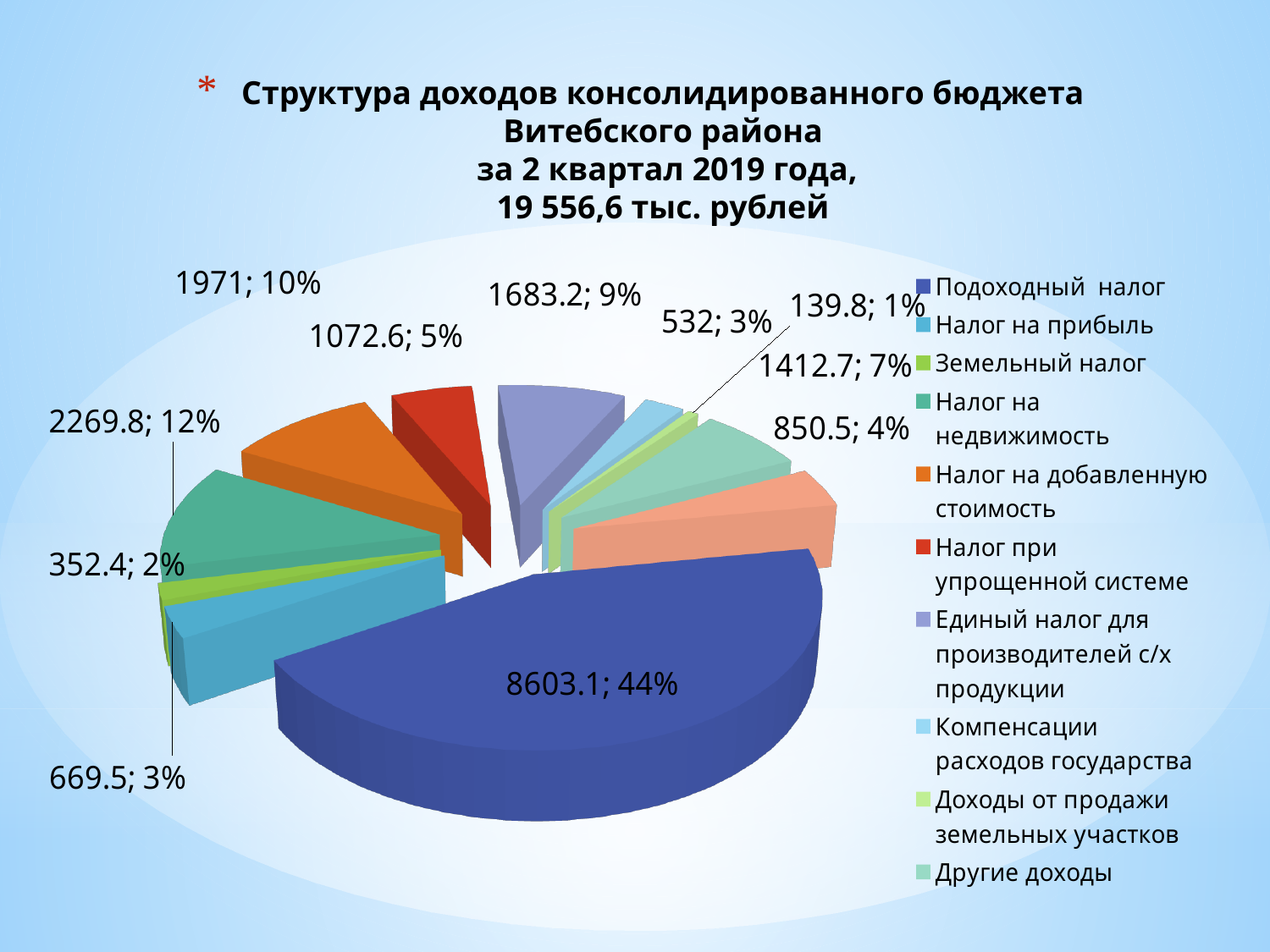
How many entries does the legend list? 10 What total amount is stated in the chart title? 19 556,6 тыс. рублей Which is larger, Налог на прибыль or Земельный налог? Налог на прибыль What value is shown for Подоходный налог? 8603.1 What value is shown for Единый налог для производителей с/х продукции? 1683.2 What kind of chart is shown on the slide? pie chart Which category has the largest slice of the pie? Подоходный налог What share of the pie does Доходы от продажи земельных участков take? 1% What is the difference between the values for Налог на недвижимость and Налог при упрощенной системе? 1197.2 What share of the pie does Подоходный налог take? 44% What share of the pie does Налог на добавленную стоимость take? 10% What value is shown for Налог на недвижимость? 2269.8